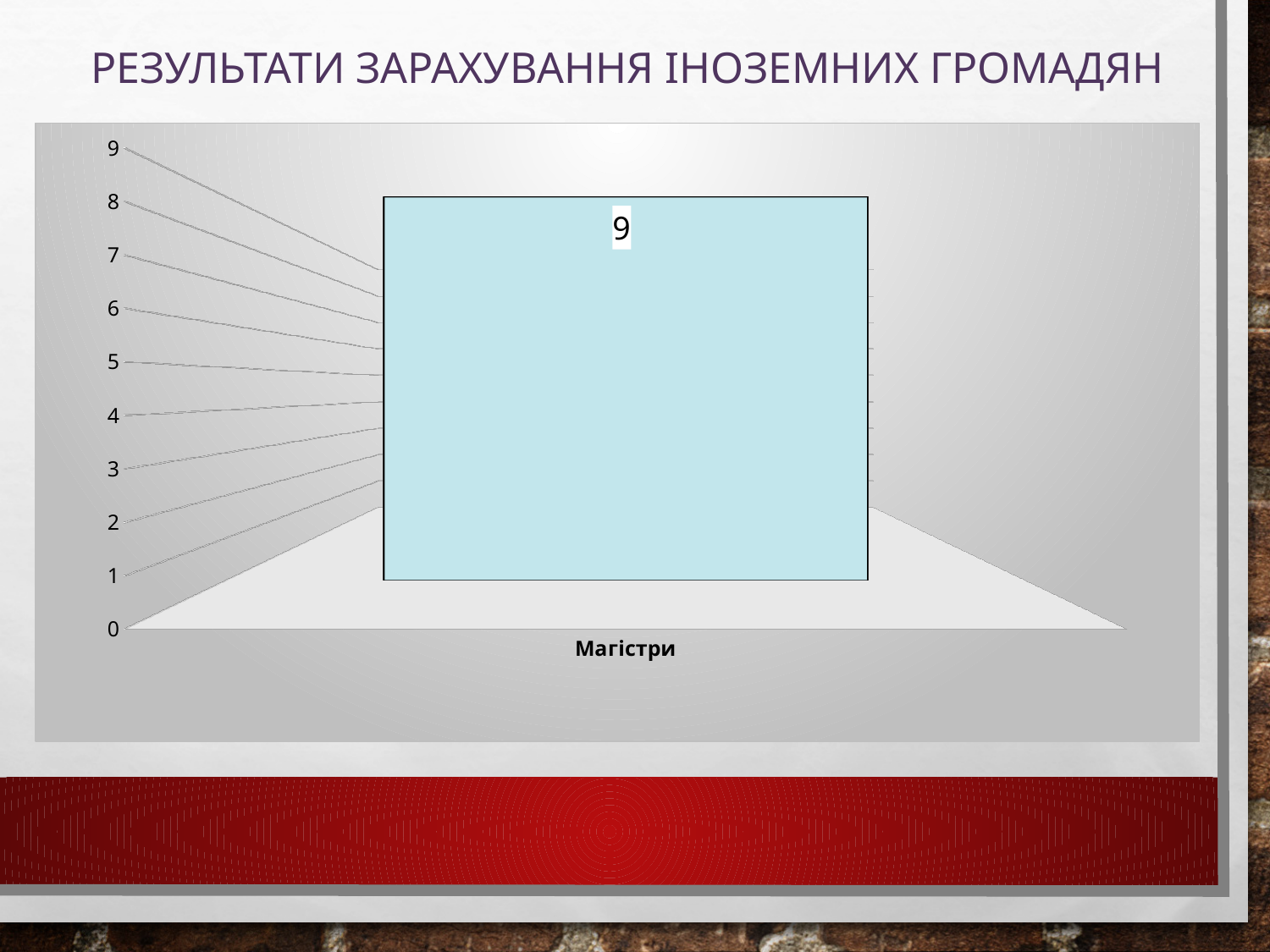
What is the highest value shown on the vertical axis? 9 Is the value for Магістри greater or less than 5? greater Is the value for Магістри greater or less than 8? greater How many categories are plotted on the chart? 1 What is the title of the slide containing the chart? РЕЗУЛЬТАТИ ЗАРАХУВАННЯ ІНОЗЕМНИХ ГРОМАДЯН What is the label of the category on the x axis? Магістри What kind of chart is shown on the slide? bar chart What is the value shown for Магістри? 9